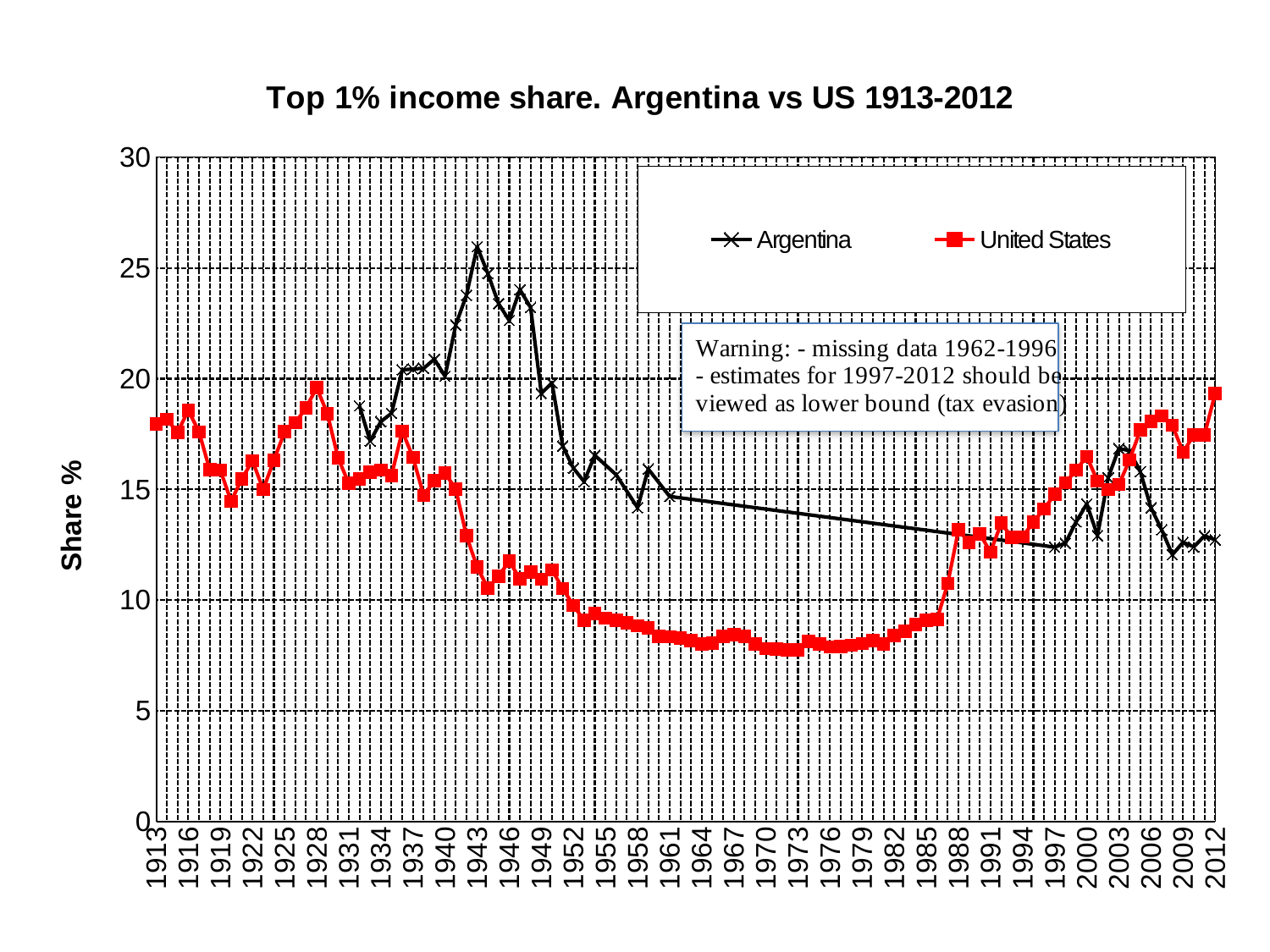
What is the title of the chart? Top 1% income share. Argentina vs US 1913-2012 What kind of chart is shown on the slide? Line chart Is the value for Argentina in 1943 greater or less than 25? greater How many series does the legend list? 2 Is the value for the United States in 1976 greater or less than 10? less In 1958, which series has the higher value, Argentina or United States? Argentina Is the value for Argentina in 2009 greater or less than 15? less Does the United States series rise or fall between 1976 and 2012? rise Which series reaches the highest value anywhere on the chart? Argentina In 2012, which series has the higher value, Argentina or United States? United States Which series is drawn with red square markers? United States